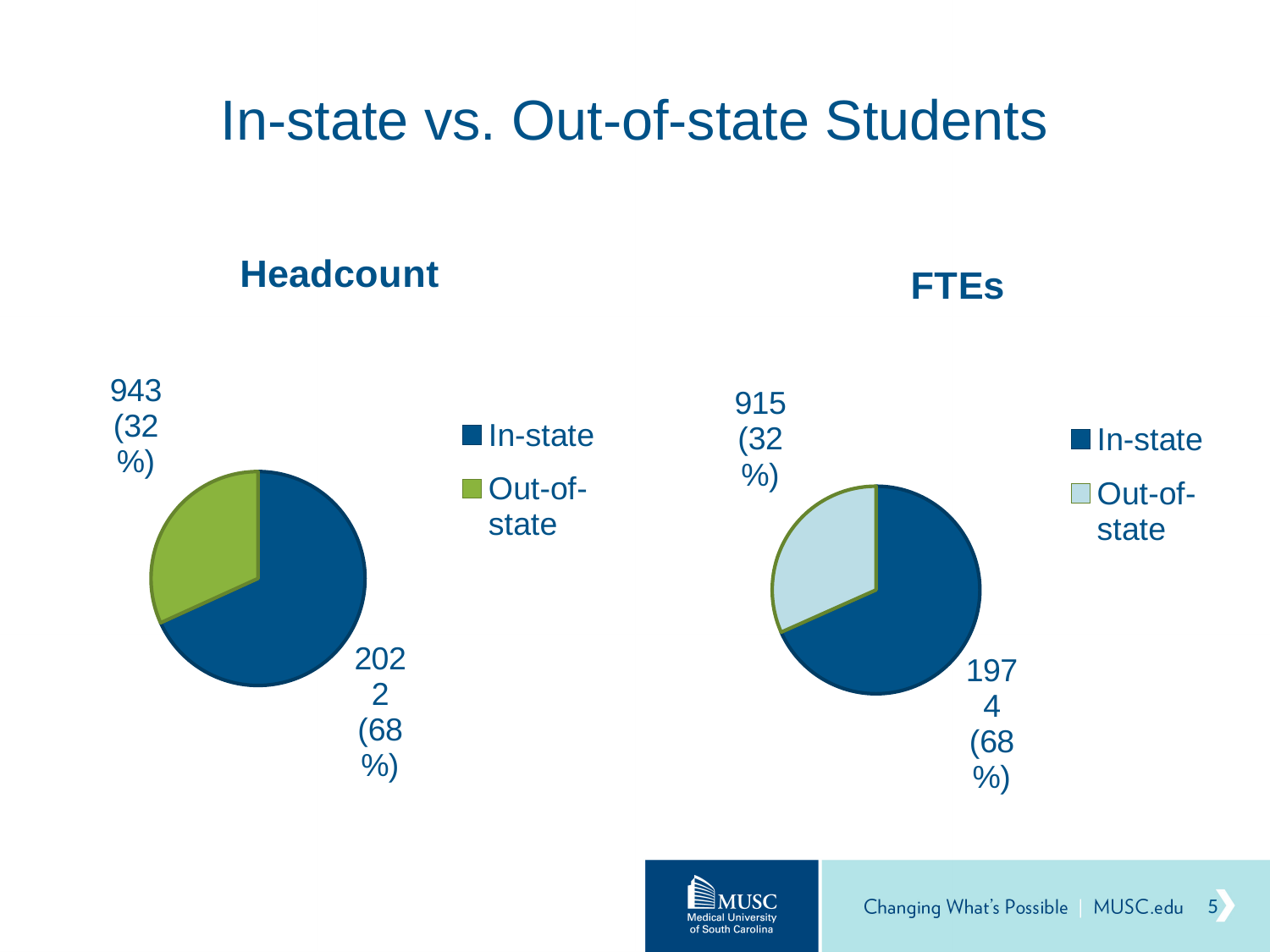
How many entries does the legend of the Headcount chart list? 2 In the Headcount chart, what is the value for Out-of-state students? 943 In the Headcount chart, what is the value for In-state students? 2022 In the FTEs chart, what is the value for Out-of-state students? 915 What kind of chart is the FTEs chart? Pie chart In the Headcount chart, what share of the pie is Out-of-state? 32% In the FTEs chart, what share of the pie is In-state? 68% In the Headcount chart, which category is the largest? In-state In the FTEs chart, what is the total of the In-state and Out-of-state values? 2889 In the FTEs chart, which category is the smallest? Out-of-state In the Headcount chart, what is the difference between the In-state and Out-of-state values? 1079 In the FTEs chart, what is the value for In-state students? 1974